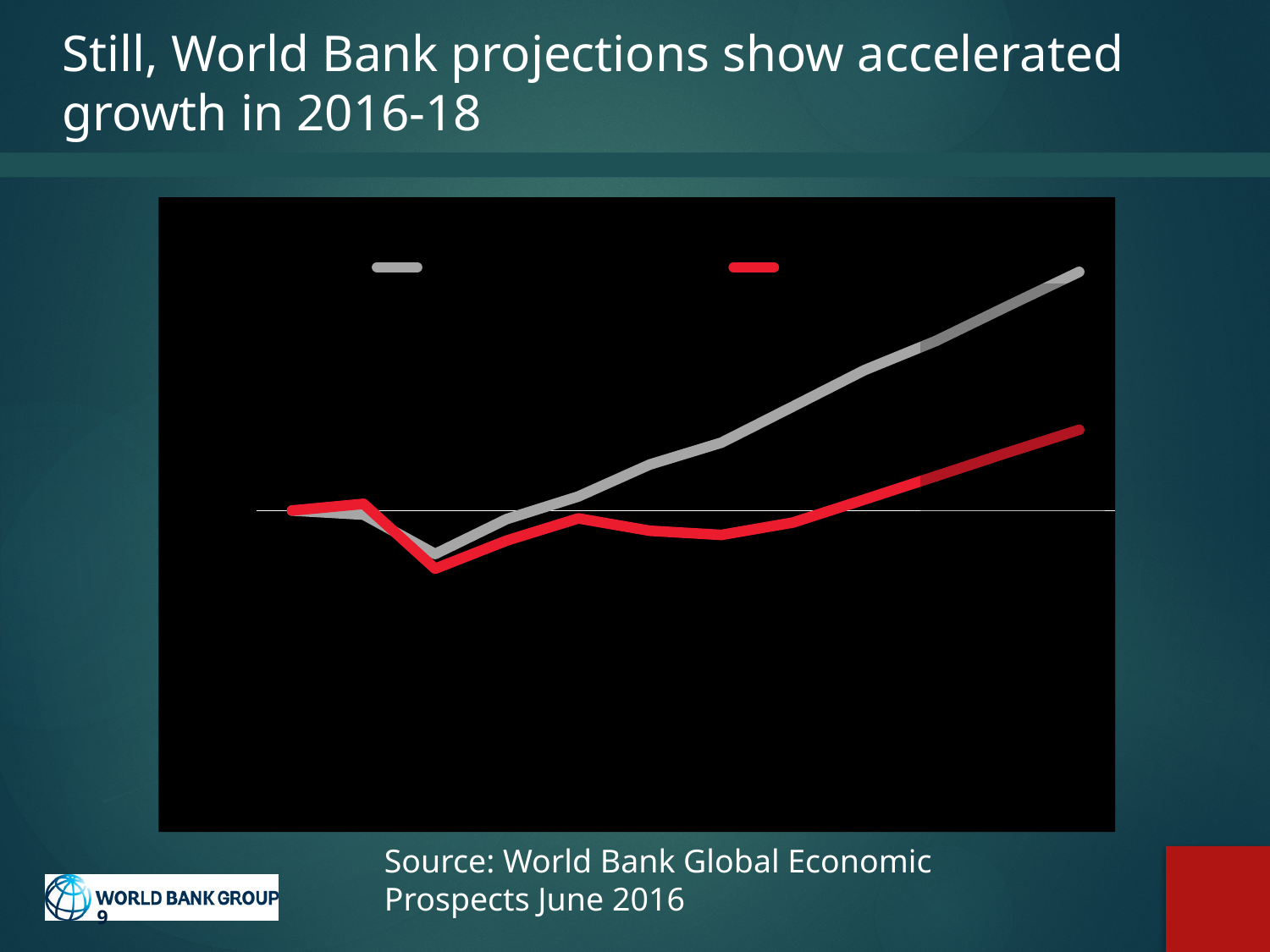
Do the values of the grey line rise or fall over the right-hand half of the chart? rise How many series does the chart's legend list? 2 Do the values of the red line rise or fall over the right-hand half of the chart? rise What colours are the two lines plotted on the chart? grey and red At the right-hand end of the chart, which line is higher, the grey line or the red line? grey line At the lowest dip near the left of the chart, which line falls lower, the grey line or the red line? red line What kind of chart is shown on the slide? line chart Which line ends at the highest point on the chart? grey line